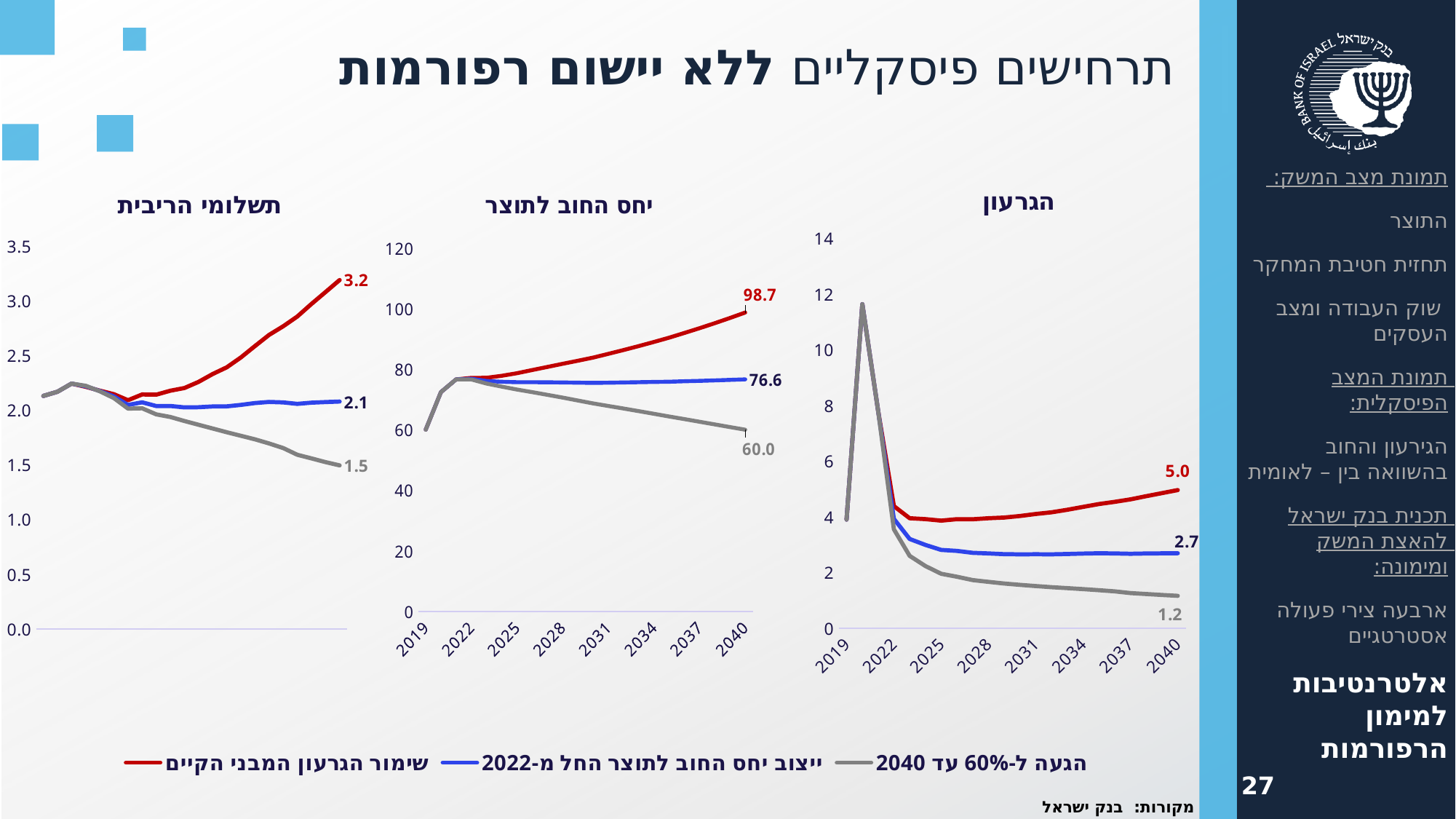
In the chart titled "יחס החוב לתוצר", does the grey series rise or fall from 2022 to 2040? fall In the chart titled "תשלומי הריבית", what is the difference between the final values of the red series and the blue series? 1.1 In the chart titled "הגרעון", which series ends at the lowest value? הגעה ל-60% עד 2040 In the chart titled "יחס החוב לתוצר", is the value of the red series in 2040 greater or less than 80? greater What kind of chart is the chart titled "הגרעון"? line chart How many series does the legend at the bottom of the slide list? 3 In the chart titled "הגרעון", what is the final value of the blue series (ייצוב יחס החוב לתוצר החל מ-2022)? 2.7 In the chart titled "יחס החוב לתוצר", which series ends at the highest value? שימור הגרעון המבני הקיים In the chart titled "הגרעון", is the final value of the red series larger or smaller than the final value of the blue series? larger In the chart titled "יחס החוב לתוצר", what is the difference between the final values of the red series and the grey series? 38.7 In the chart titled "תשלומי הריבית", what is the final value of the grey series (הגעה ל-60% עד 2040)? 1.5 In the chart titled "יחס החוב לתוצר", what is the final value of the red series (שימור הגרעון המבני הקיים)? 98.7